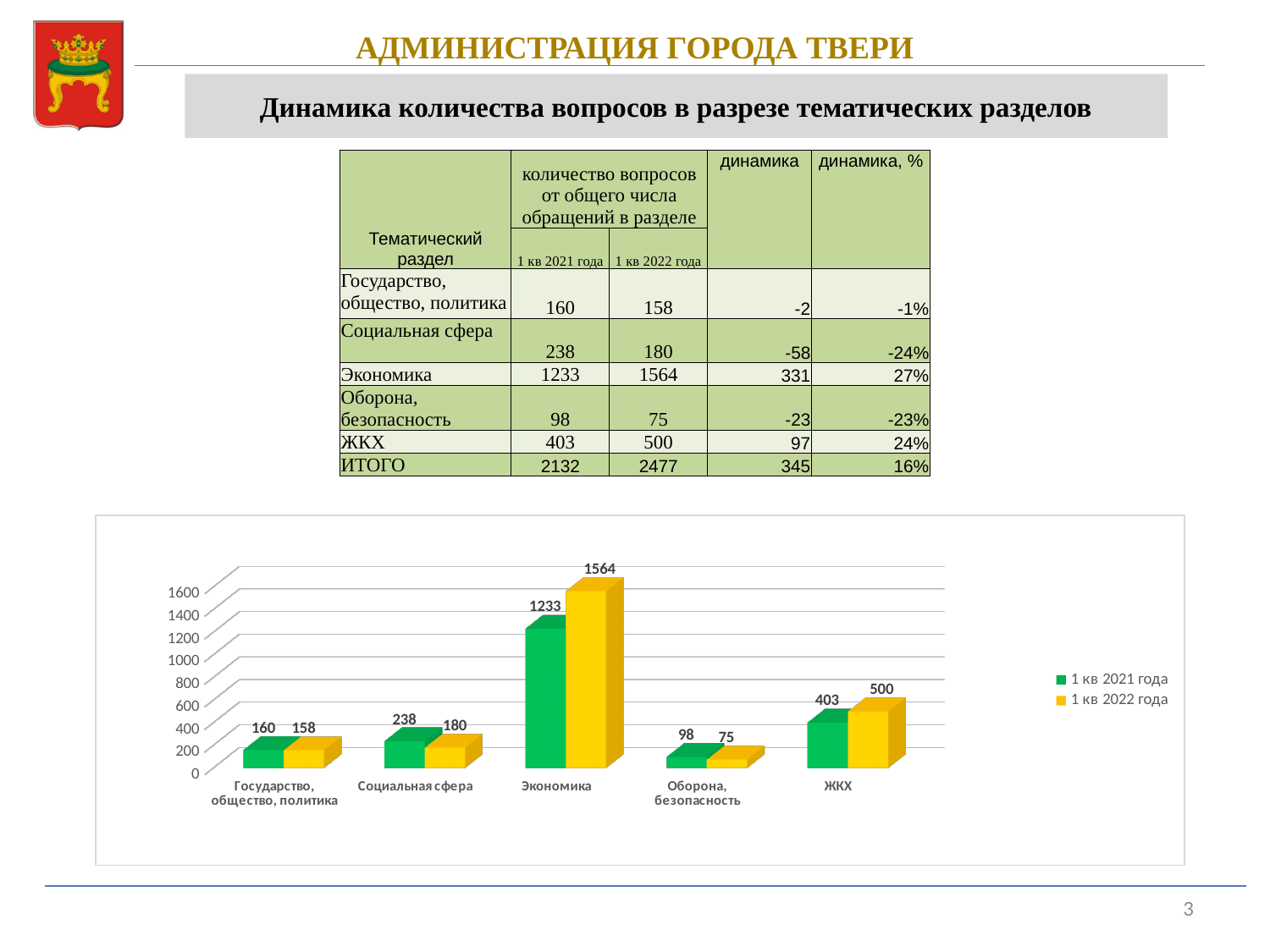
What kind of chart is shown on the slide? bar chart What is the value for ЖКХ in the 1 кв 2021 года series? 403 How many categories are shown on the x axis of the chart? 5 What is the value for Оборона, безопасность in the 1 кв 2022 года series? 75 How many series does the chart legend list? 2 What is the difference between the 1 кв 2022 года and 1 кв 2021 года values for Социальная сфера? -58 What is the difference between the 1 кв 2022 года and 1 кв 2021 года values for ЖКХ? 97 What is the value for Экономика in the 1 кв 2022 года series? 1564 What colour are the bars for the 1 кв 2022 года series? yellow Which category has the lowest value in the 1 кв 2022 года series? Оборона, безопасность Which category has the highest value in the 1 кв 2021 года series? Экономика Which is larger for Государство, общество, политика: the 1 кв 2021 года value or the 1 кв 2022 года value? 1 кв 2021 года